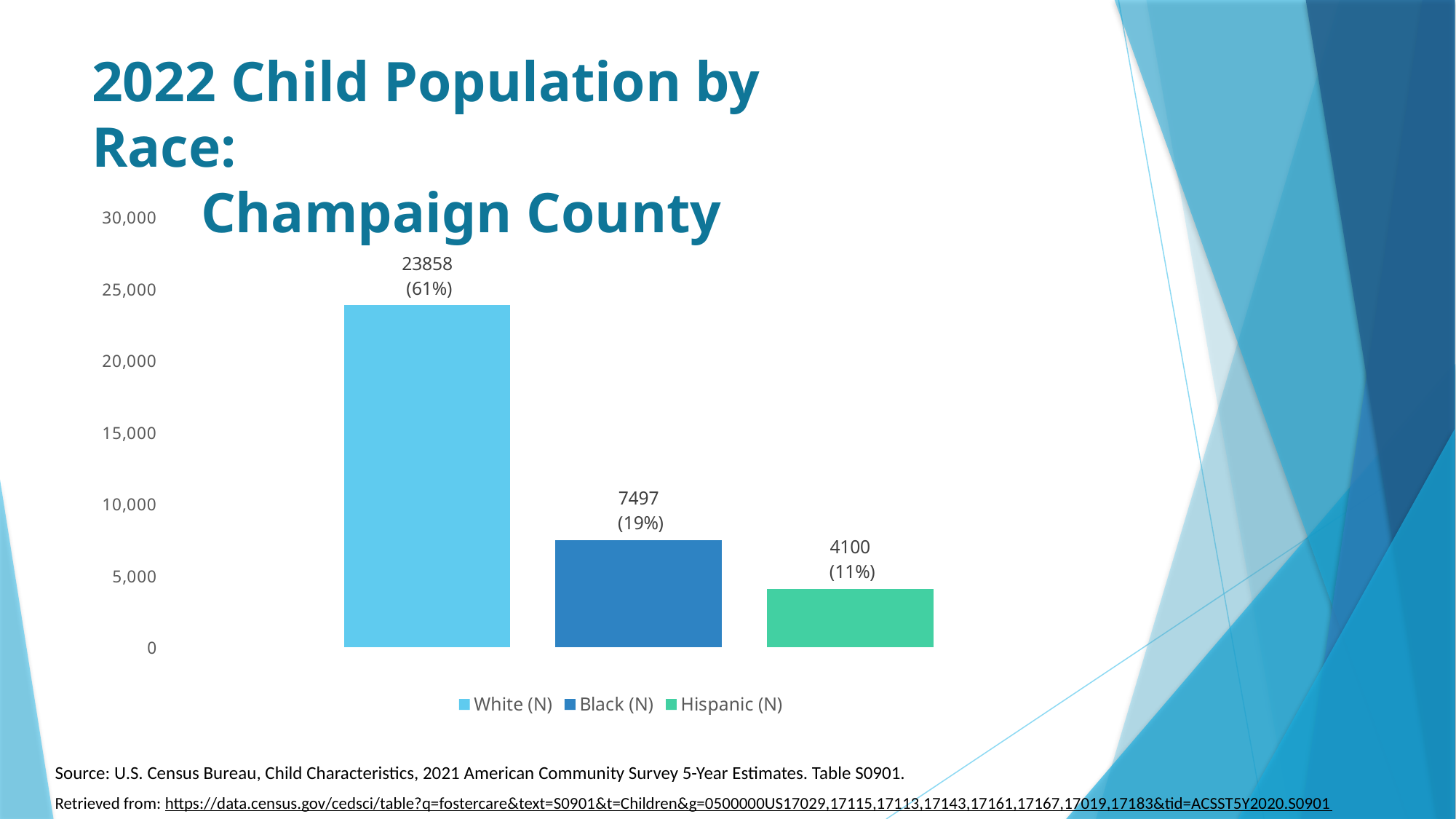
What is the difference between the values for Black (N) and Hispanic (N)? 3397 What is the title of the chart? 2022 Child Population by Race: Champaign County What percentage is shown for Black (N)? 19% Which group has the highest child population? White (N) What is the value for Black (N)? 7497 Which is larger, the value for Black (N) or Hispanic (N)? Black (N) Which group has the lowest child population? Hispanic (N) What is the difference between the values for White (N) and Black (N)? 16361 What kind of chart is shown on the slide? Bar chart What is the value for Hispanic (N)? 4100 How many series does the legend list? 3 What is the value for White (N)? 23858